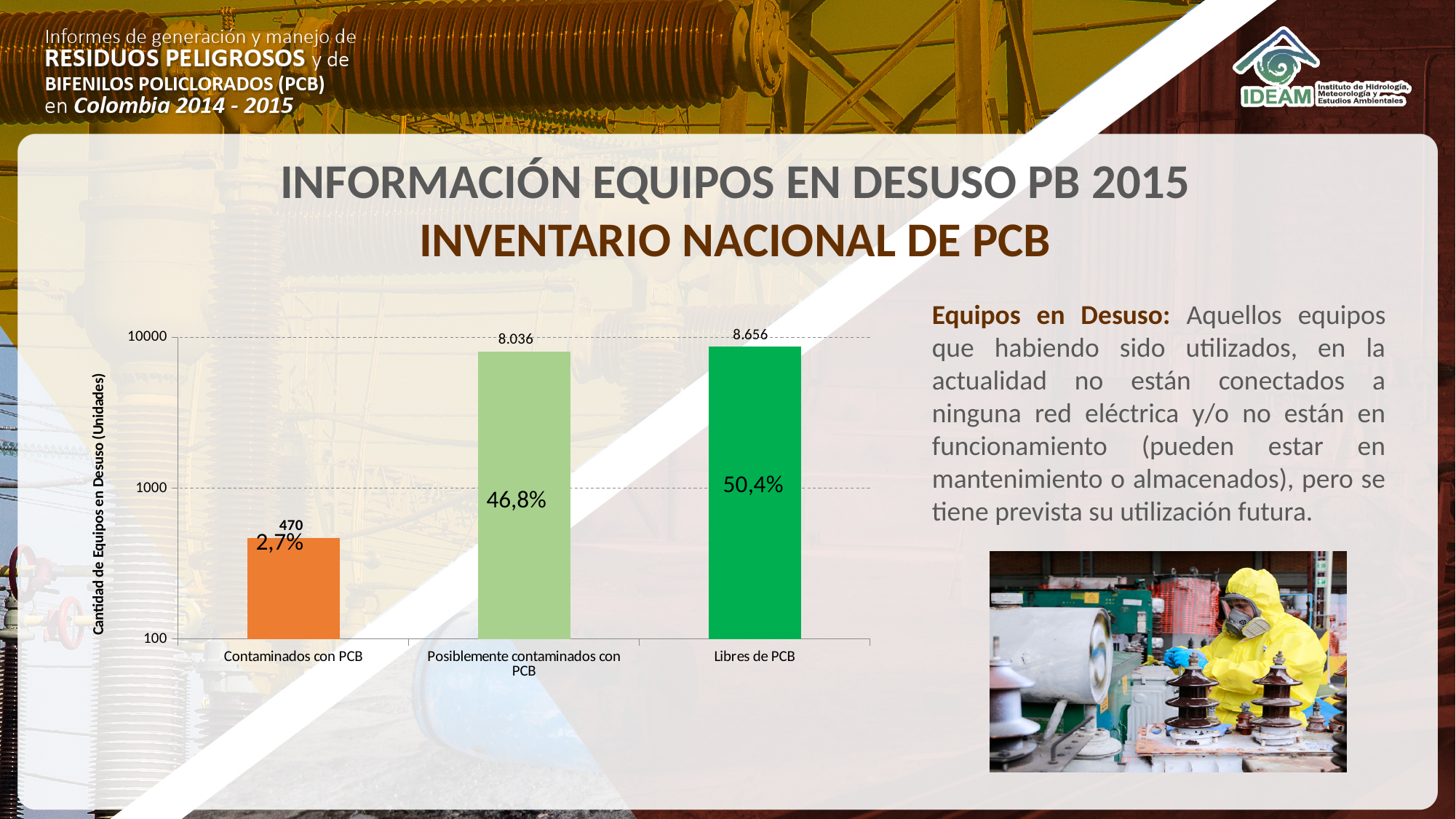
Which category has the highest value? Libres de PCB What percentage is shown on the bar for Libres de PCB? 50,4% Which category has the lowest value? Contaminados con PCB What percentage is shown on the bar for Contaminados con PCB? 2,7% What is the value for Contaminados con PCB? 470 Is the value for Contaminados con PCB greater or less than 1000? less How many categories are shown on the x axis? 3 What is the value for Libres de PCB? 8.656 What is the difference between the values for Libres de PCB and Posiblemente contaminados con PCB? 620 What kind of chart is shown on the slide? bar chart What is the value for Posiblemente contaminados con PCB? 8.036 Which is larger, the value for Contaminados con PCB or the value for Posiblemente contaminados con PCB? Posiblemente contaminados con PCB